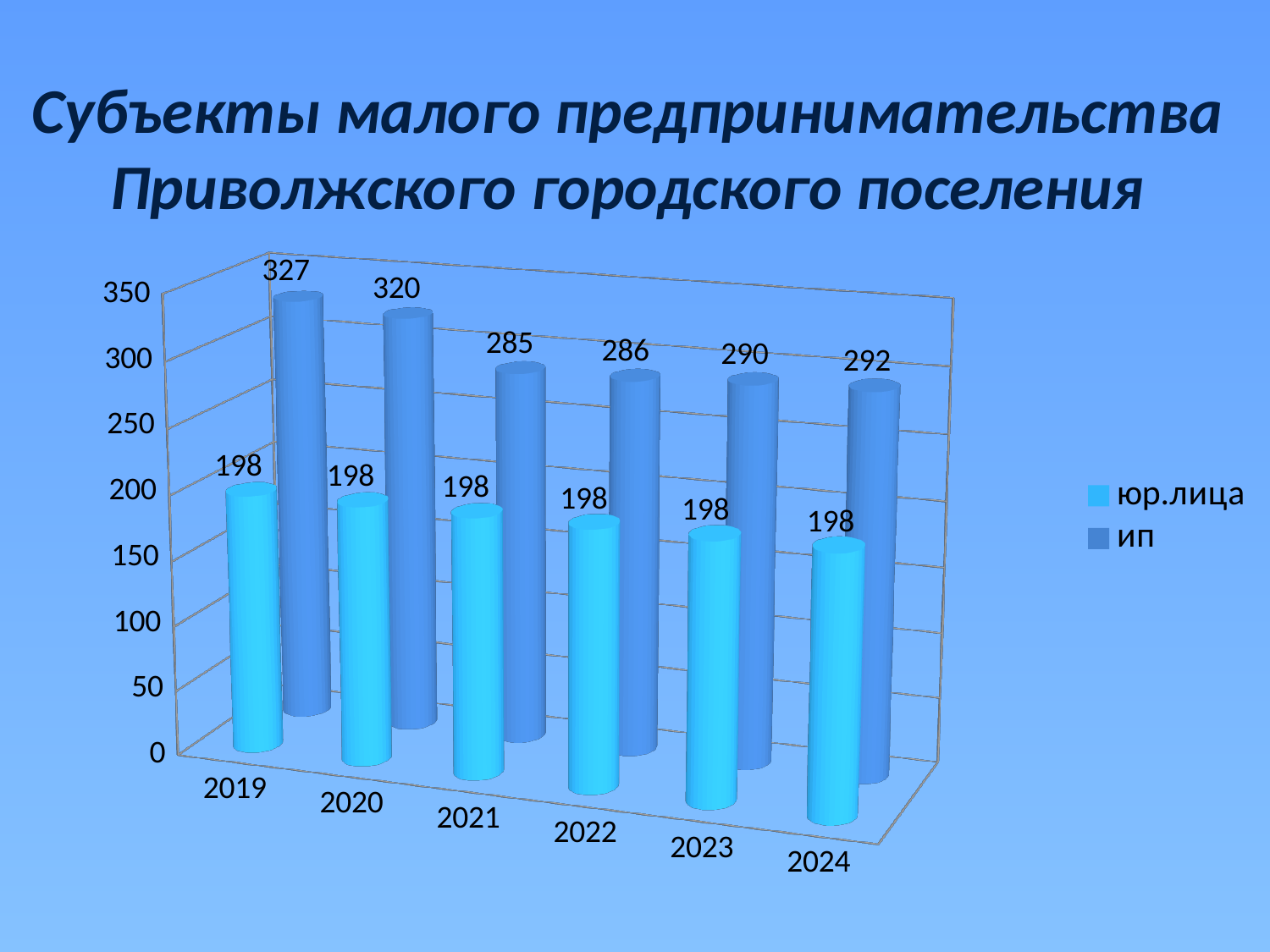
What kind of chart is shown on the slide? bar chart What is the value for ип in 2024? 292 How many series does the legend list? 2 In which year is the value for ип lowest? 2021 Does the value for ип rise or fall from 2021 to 2024? rise What is the difference between the ип and юр.лица values in 2024? 94 What is the value for юр.лица in 2022? 198 What is the difference between the ип values for 2019 and 2021? 42 In which year is the value for ип highest? 2019 Which is larger in 2020, the value for ип or for юр.лица? ип How many years are shown on the x axis? 6 What is the value for ип in 2019? 327